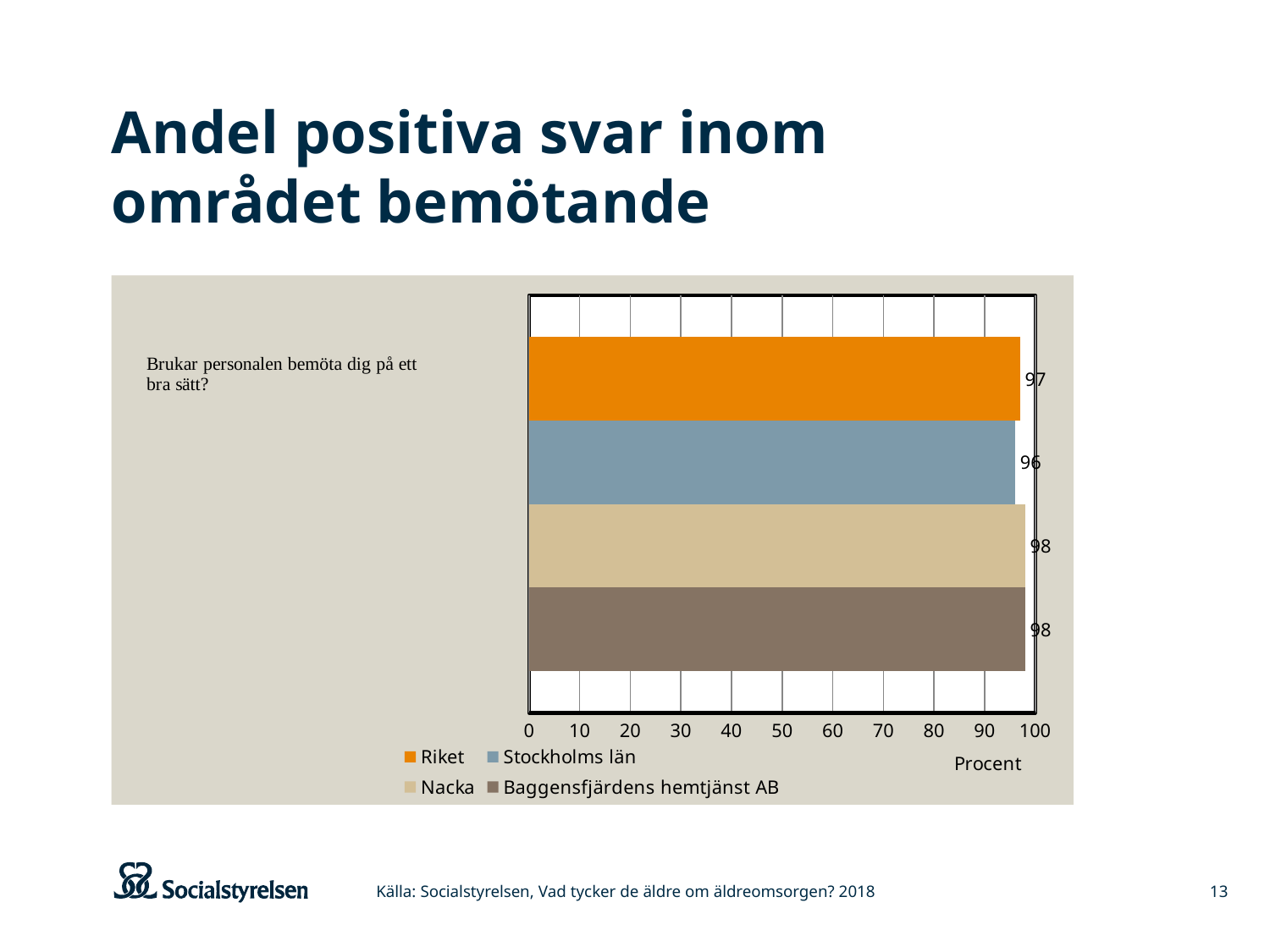
What is the value for Baggensfjärdens hemtjänst AB? 98 Which series has the lowest value? Stockholms län What kind of chart is shown on the slide? bar chart What is the value for Stockholms län? 96 What is the value for Nacka? 98 How many series does the legend list? 4 What is the value for Riket? 97 What is the difference between the values for Nacka and Stockholms län? 2 What is the label of the x axis? Procent Which is larger, the value for Riket or the value for Stockholms län? Riket Is the value for Stockholms län greater or less than 90? greater What is the difference between the values for Riket and Stockholms län? 1